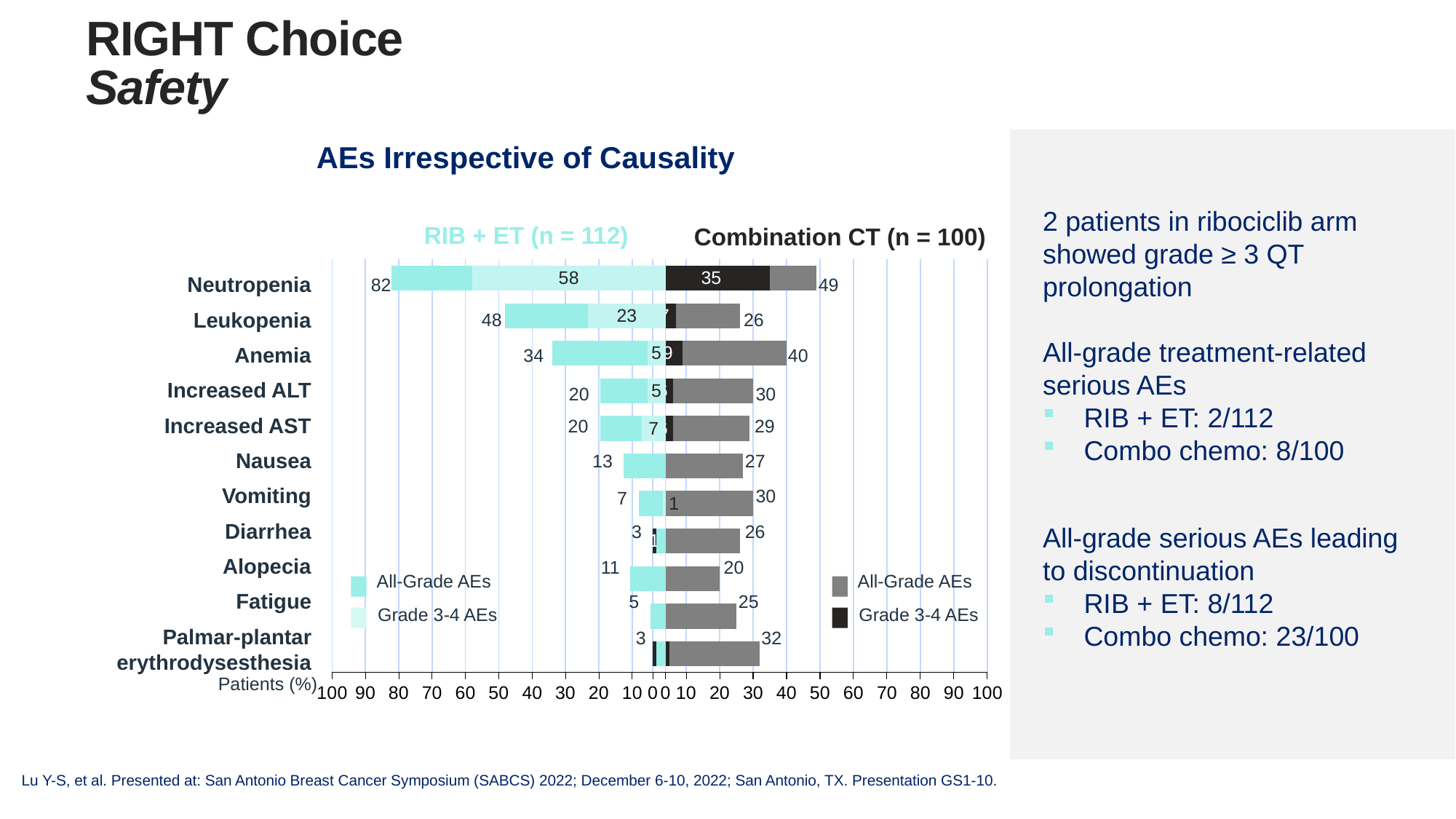
What is the all-grade AE percentage for Neutropenia in the RIB + ET arm? 82 What is the title of the chart? AEs Irrespective of Causality What is the difference between the all-grade Neutropenia percentages in the RIB + ET arm and the Combination CT arm? 33 What is the all-grade AE percentage for Vomiting in the RIB + ET arm? 7 Which adverse event has the highest all-grade percentage in the Combination CT arm? Neutropenia What is the grade 3-4 AE percentage for Neutropenia in the Combination CT arm? 35 How many entries does the RIB + ET legend list? 2 Which adverse event has the lowest all-grade percentage in the Combination CT arm? Alopecia What is the all-grade AE percentage for Anemia in the Combination CT arm? 40 How many adverse event categories are listed on the chart? 11 For all-grade Anemia, which arm has the larger percentage, RIB + ET or Combination CT? Combination CT What kind of chart is shown on the slide? Bar chart